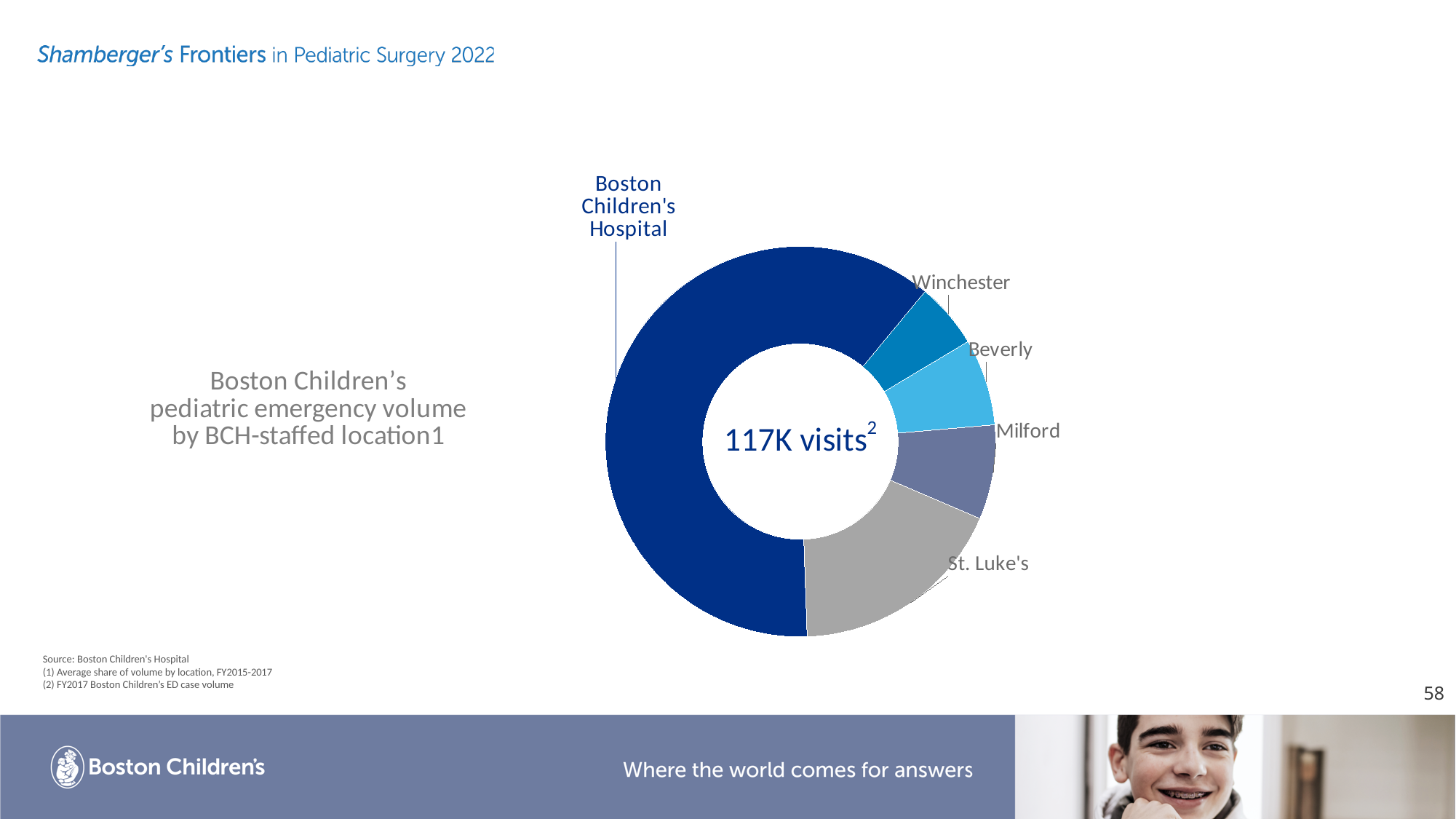
Which is larger in the chart, the slice for Boston Children's Hospital or the slice for St. Luke's? Boston Children's Hospital What text is printed in the center of the donut chart? 117K visits Which location's slice is shown in grey? St. Luke's What kind of chart is shown on the slide? Pie chart (donut) Which is larger in the chart, the slice for Milford or the slice for Boston Children's Hospital? Boston Children's Hospital How many locations are shown as slices in the chart? 5 Which location has the largest share of pediatric emergency volume in the chart? Boston Children's Hospital Which location has the second-largest slice in the chart? St. Luke's Which is larger in the chart, the slice for St. Luke's or the slice for Milford? St. Luke's